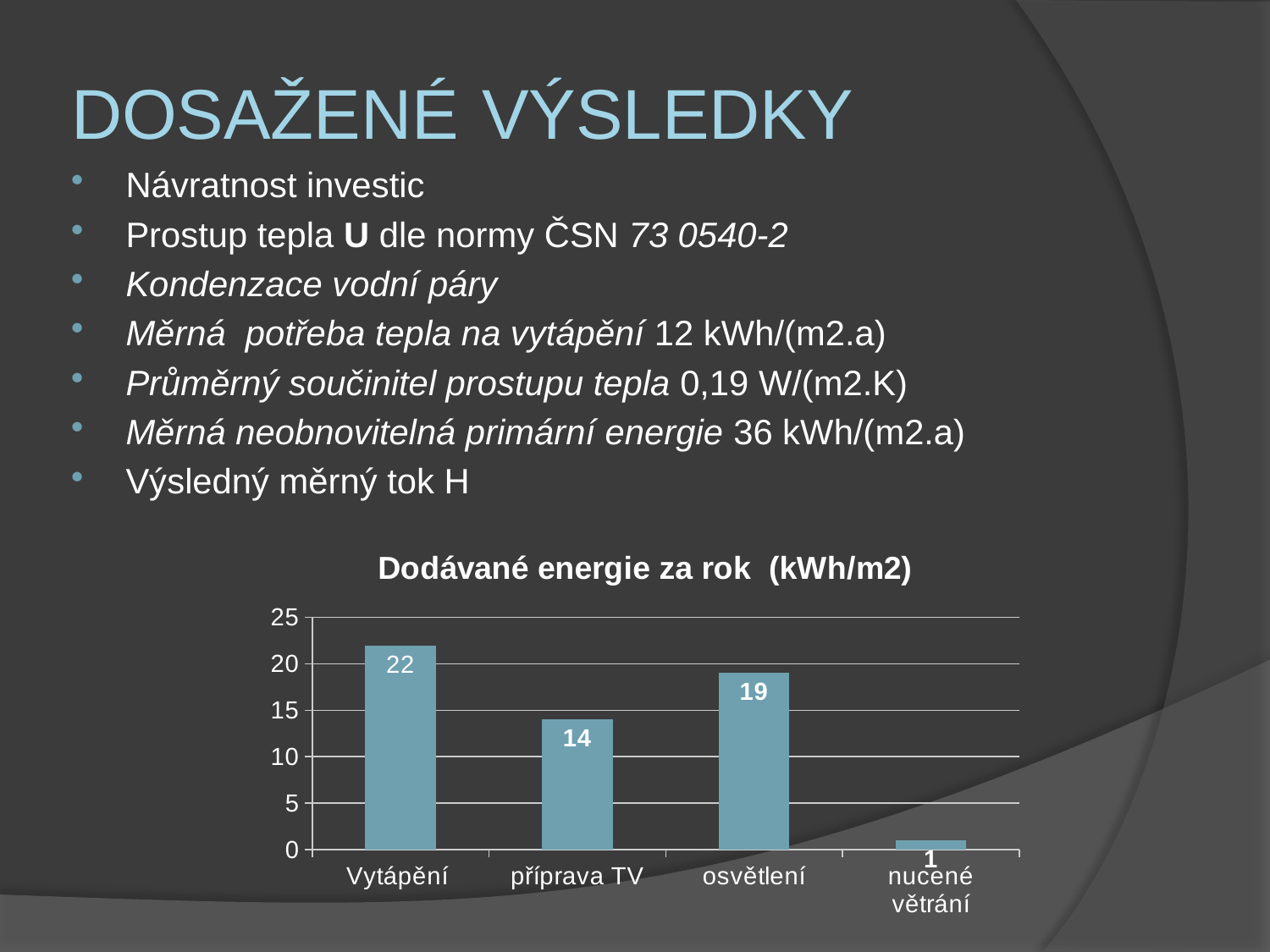
What is the value for Vytápění in the chart? 22 Which category has the lowest value in the chart? nucené větrání What is the value for příprava TV in the chart? 14 What is the difference between the values for Vytápění and příprava TV? 8 What kind of chart is shown on the slide? bar chart Is the value for osvětlení greater or less than 15? greater How many categories are shown in the chart? 4 What is the value for nucené větrání in the chart? 1 What is the title of the chart? Dodávané energie za rok (kWh/m2) What is the value for osvětlení in the chart? 19 Which is larger, the value for osvětlení or the value for příprava TV? osvětlení Which category has the highest value in the chart? Vytápění